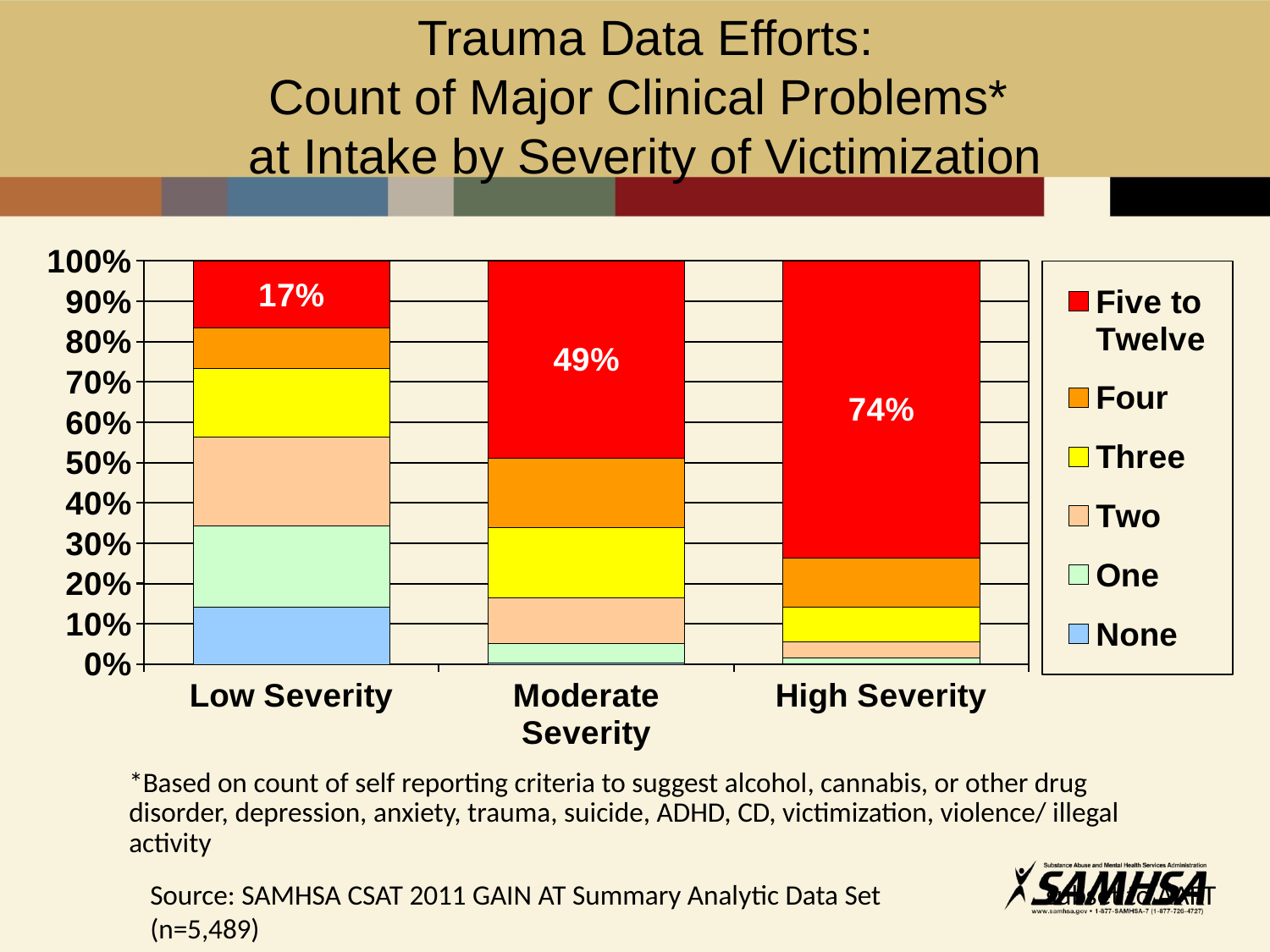
What percentage of the High Severity group had Five to Twelve major clinical problems? 74% Is the share of the Low Severity group with None of the major clinical problems greater or less than 20%? less Which severity group has the lowest share of Five to Twelve major clinical problems? Low Severity Which severity group has the highest share of Five to Twelve major clinical problems? High Severity What percentage of the Low Severity group had Five to Twelve major clinical problems? 17% How many series does the legend list? 6 Which group has a larger Five to Twelve share, Low Severity or Moderate Severity? Moderate Severity What percentage of the Moderate Severity group had Five to Twelve major clinical problems? 49% How many severity categories are shown on the x axis? 3 Does the share of Five to Twelve major clinical problems rise or fall as severity of victimization increases from Low to High? Rises What is the difference in the Five to Twelve share between the High Severity and Low Severity groups? 57 percentage points What kind of chart is shown on the slide? Stacked bar chart